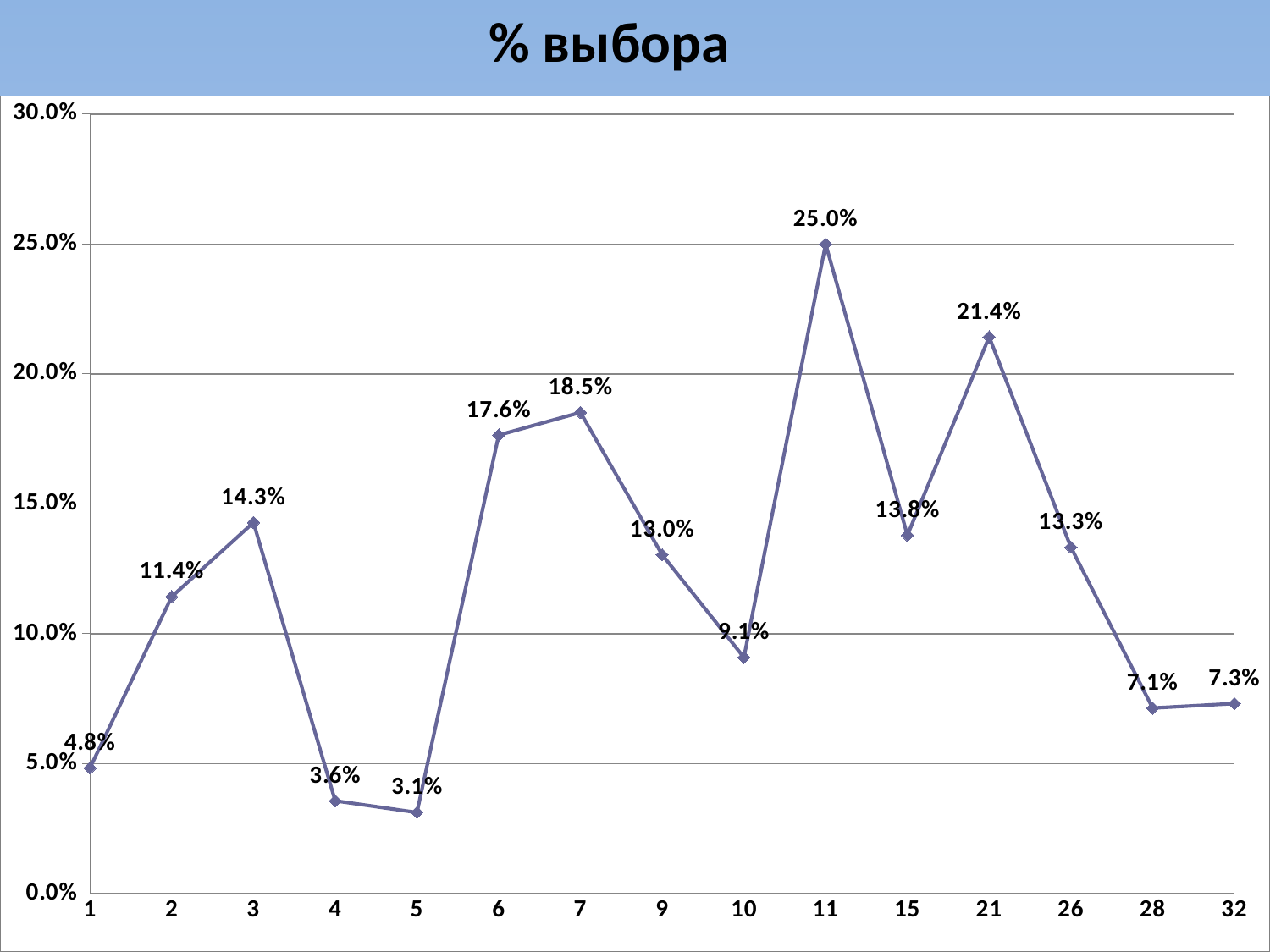
Which is larger, the value for category 3 or the value for category 9? 3 Is the value for category 6 greater or less than 15.0%? greater How many data points are plotted on the chart? 15 What is the value for category 11? 25.0% What is the difference between the values for category 7 and category 6? 0.9% What is the value for category 5? 3.1% What is the difference between the values for category 11 and category 21? 3.6% What kind of chart is shown on the slide? line chart Which category has the highest value? 11 What is the title of the chart? % выбора Which category has the lowest value? 5 What is the value for category 21? 21.4%